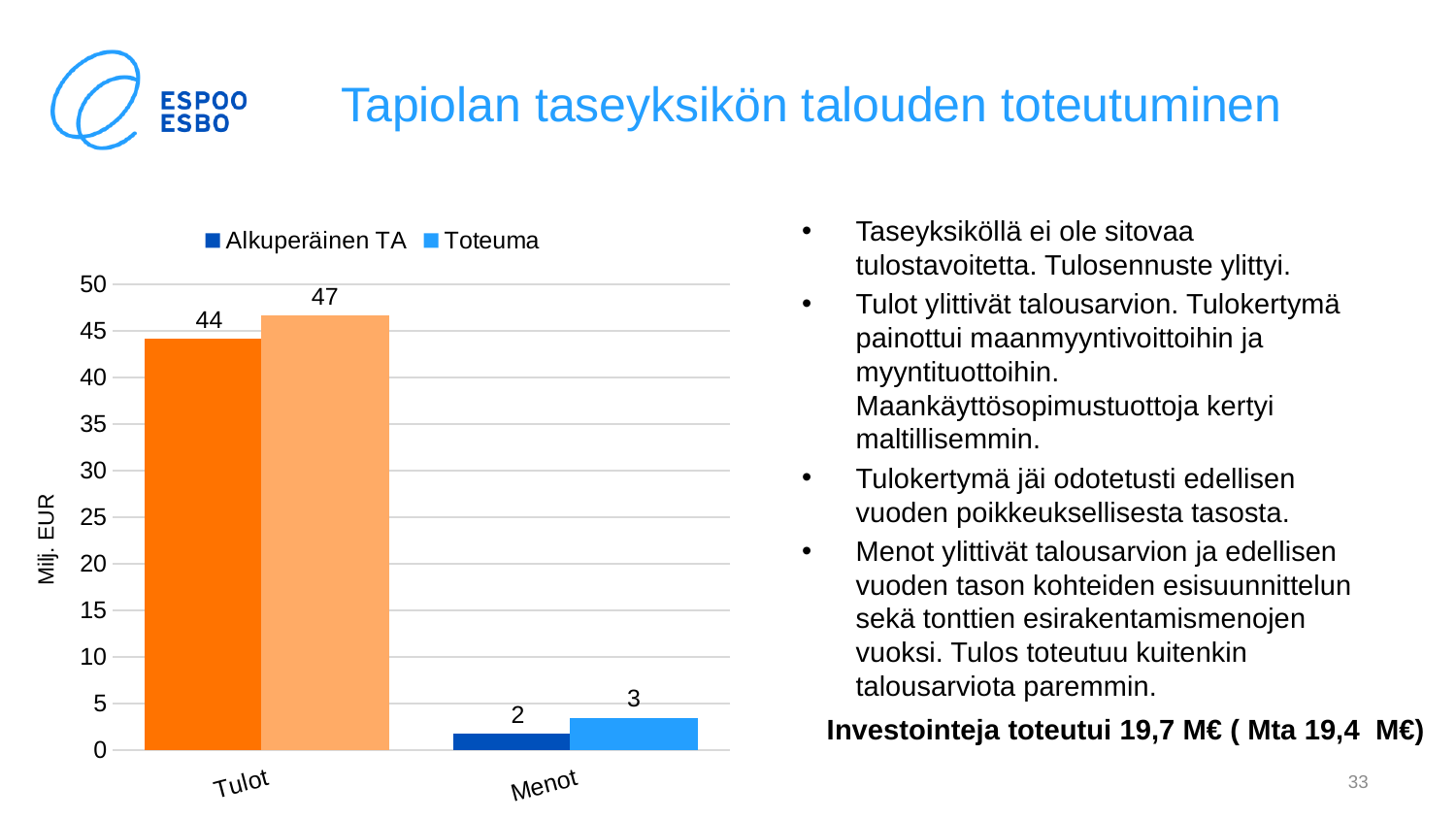
How many series does the legend list? 2 What is the label of the y axis? Milj. EUR Which category has the lowest Alkuperäinen TA value? Menot What is the Toteuma value for Tulot? 47 Which is larger for Menot: Alkuperäinen TA or Toteuma? Toteuma What is the Alkuperäinen TA value for Menot? 2 What is the Toteuma value for Menot? 3 What is the Alkuperäinen TA value for Tulot? 44 How many categories are shown on the x axis? 2 What is the difference between the Toteuma and Alkuperäinen TA values for Tulot? 3 What kind of chart is shown on the slide? Bar chart Which category has the highest Toteuma value? Tulot